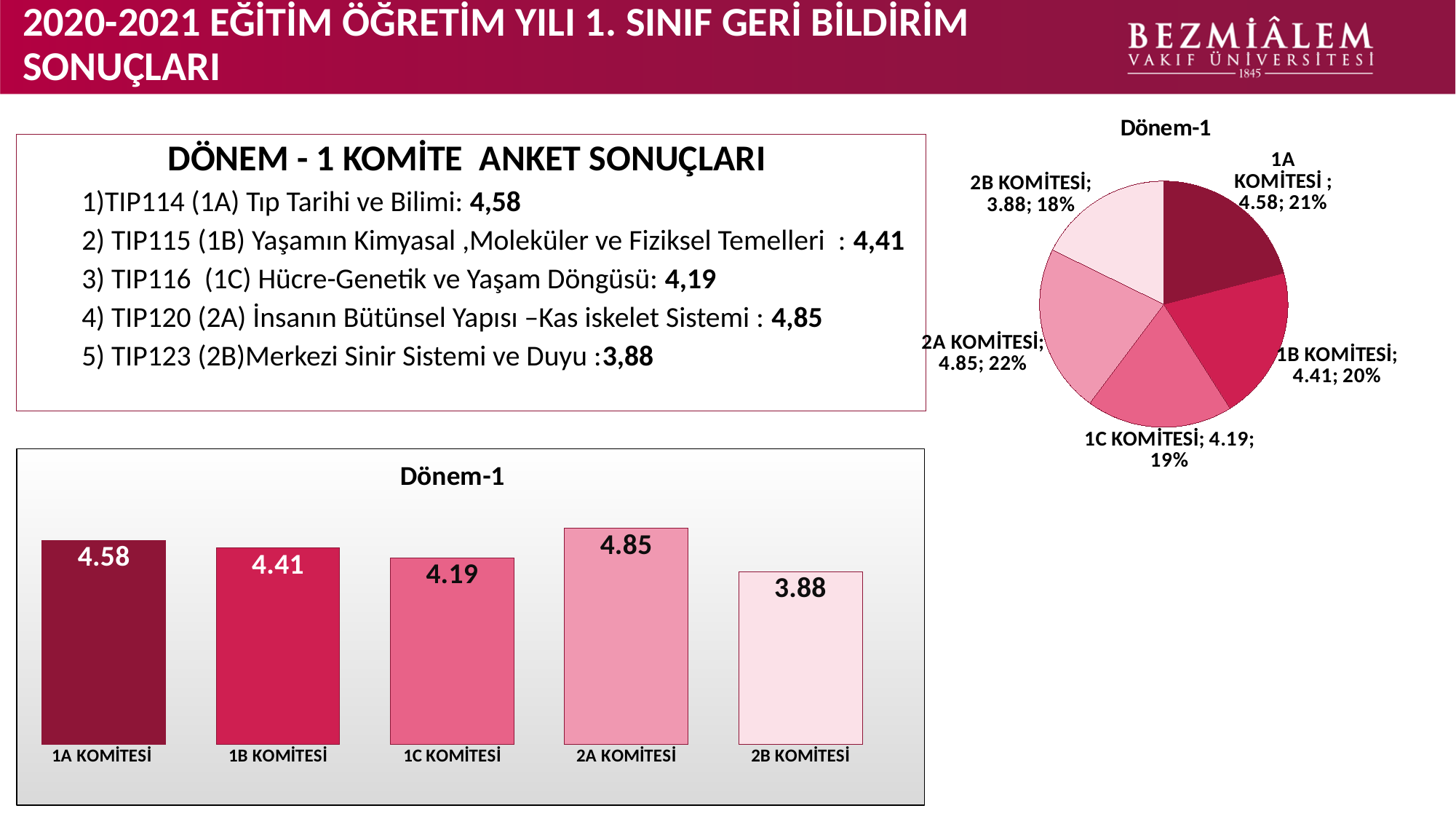
What is the title of the bar chart at the bottom left? Dönem-1 In the pie chart at the top right, what share does 1C KOMİTESİ have? 19% In the bar chart at the bottom left, which category has the lowest value? 2B KOMİTESİ How many bars are in the bar chart at the bottom left? 5 In the pie chart at the top right, what share does 2A KOMİTESİ have? 22% In the bar chart at the bottom left, what is the value for 2A KOMİTESİ? 4.85 In the bar chart at the bottom left, what is the value for 2B KOMİTESİ? 3.88 In the bar chart at the bottom left, which is larger, the value for 1B KOMİTESİ or the value for 1C KOMİTESİ? 1B KOMİTESİ In the bar chart at the bottom left, what is the difference between the values for 1A KOMİTESİ and 1C KOMİTESİ? 0.39 In the bar chart at the bottom left, which category has the highest value? 2A KOMİTESİ What kind of chart is the chart at the bottom left of the slide? bar chart What kind of chart is the chart at the top right of the slide? pie chart